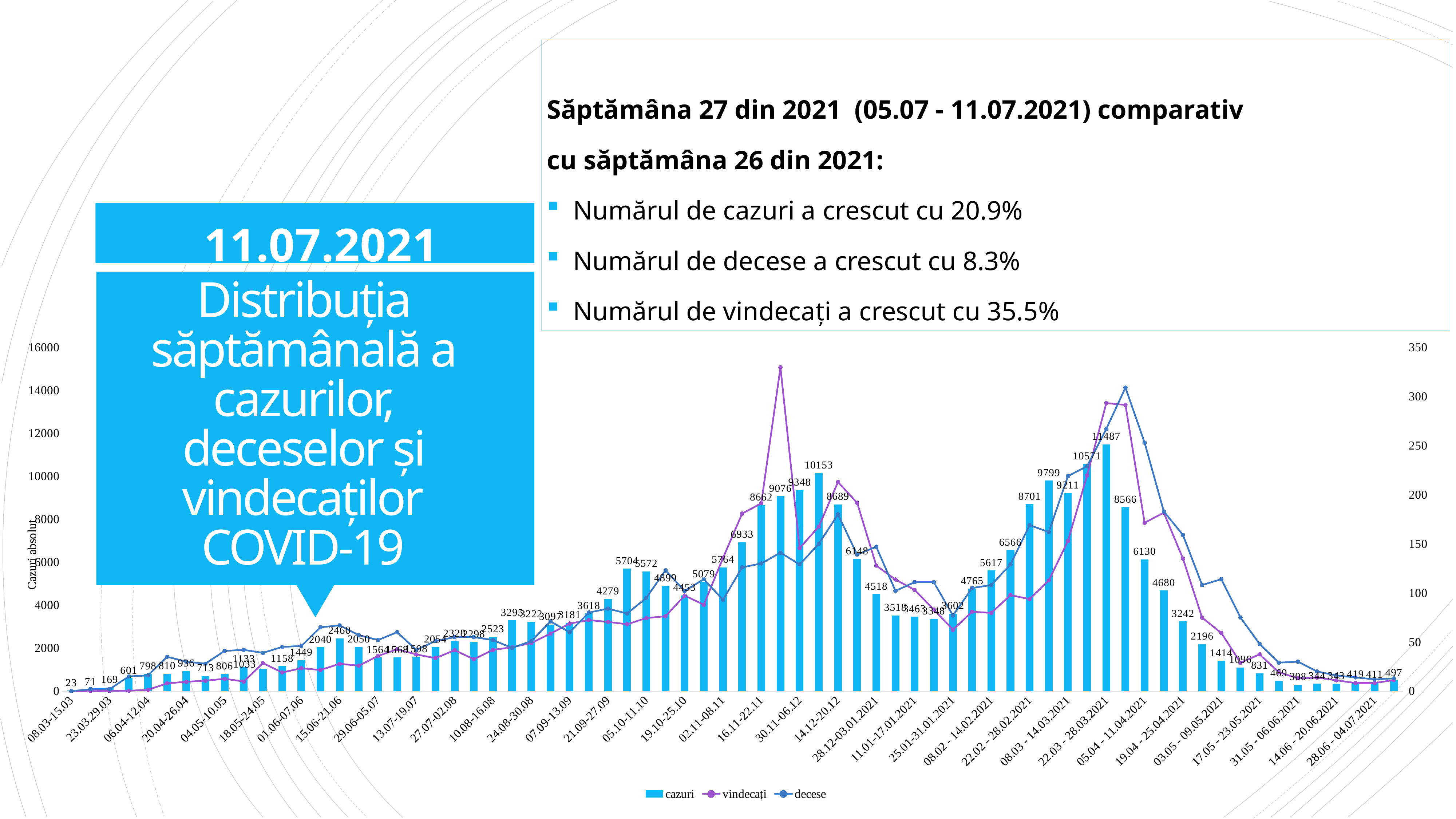
Do the cazuri bars rise or fall after the week 22.03 - 28.03.2021? fall Is the peak of the decese line greater or less than 250 on the right axis? greater Which week has the highest cazuri bar? 22.03 - 28.03.2021 What kind of chart is shown on the slide? Combined bar and line chart What is the maximum value shown on the right-hand axis? 350 What is the cazuri value for the first week, 08.03-15.03? 23 Which cazuri value is larger, 10153 or 9348? 10153 Which series are listed in the chart legend? cazuri, vindecați, decese How many series does the chart legend list? 3 What is the difference between the two highest cazuri bars, 11487 and 10153? 1334 What is the highest value of the cazuri bars? 11487 What is the cazuri value for the last bar on the chart? 497